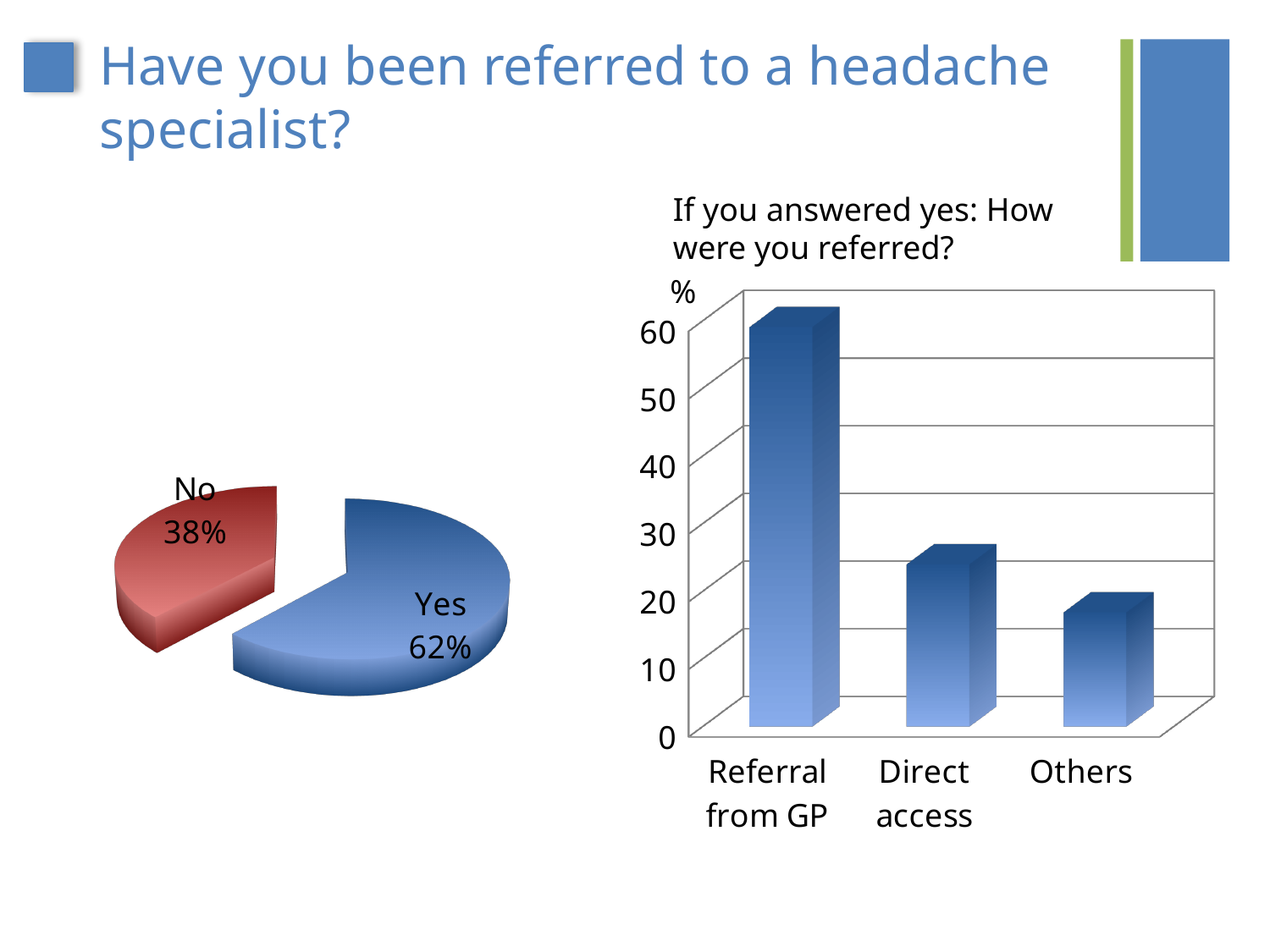
In the pie chart on the left, how many percentage points larger is the Yes slice than the No slice? 24 In the pie chart on the left, how many slices are there? 2 In the chart titled 'If you answered yes: How were you referred?', is the value for Referral from GP greater or less than 50? greater In the pie chart on the left, what percentage answered No? 38% In the chart titled 'If you answered yes: How were you referred?', how many categories are shown on the x axis? 3 What kind of chart is the chart on the left of the slide? Pie chart In the pie chart on the left, what percentage answered Yes? 62% In the pie chart on the left, which slice is larger, Yes or No? Yes What kind of chart is the chart titled 'If you answered yes: How were you referred?'? Bar chart In the chart titled 'If you answered yes: How were you referred?', which category has the highest value? Referral from GP In the chart titled 'If you answered yes: How were you referred?', is the value for Direct access greater or less than 30? less In the chart titled 'If you answered yes: How were you referred?', which category has the lowest value? Others